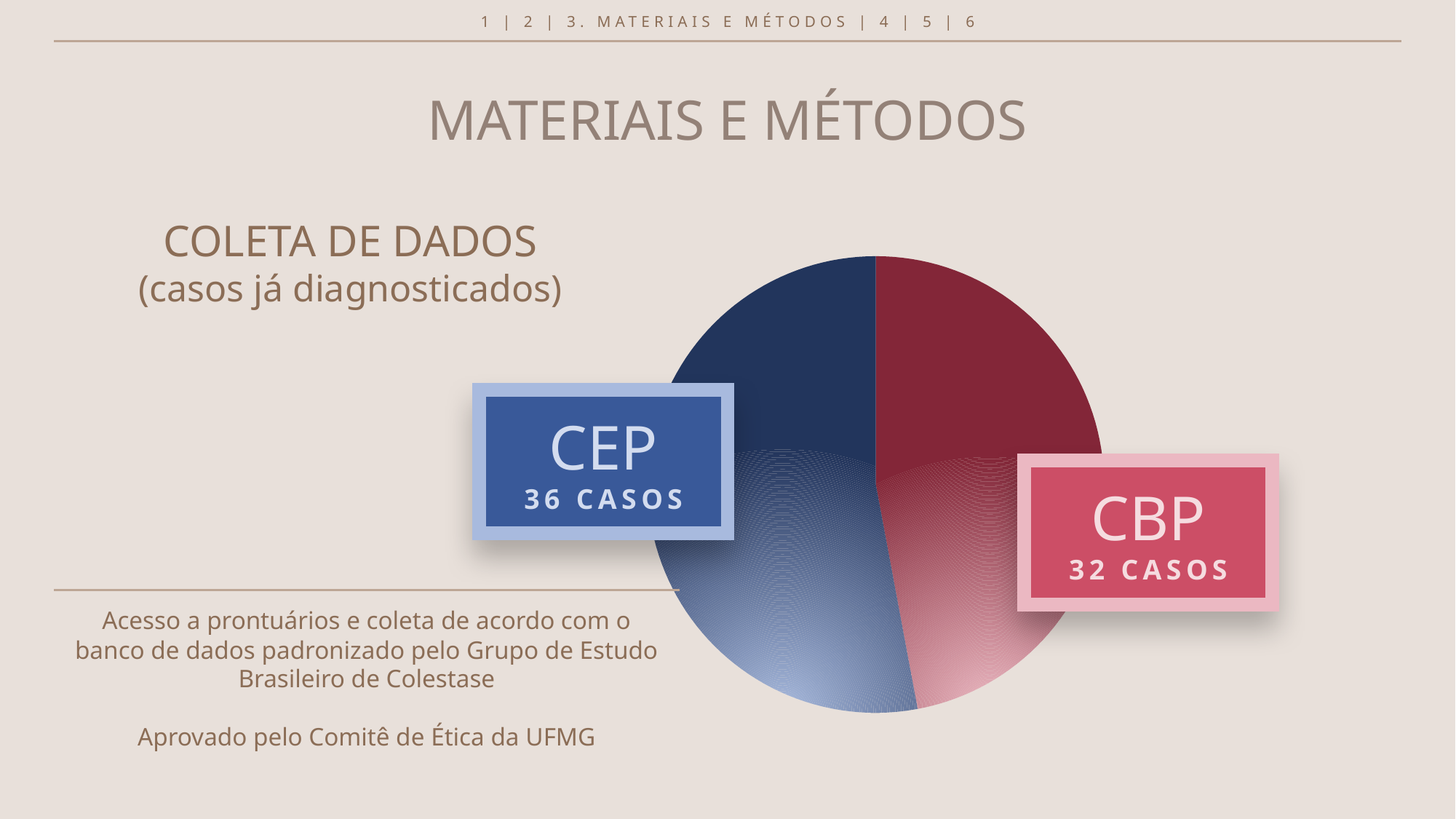
How many slices does the pie chart have? 2 Which category in the pie chart has the smaller number of cases? CBP Which has more cases, CBP or CEP? CEP How many cases does the CEP slice of the pie chart represent? 36 casos What is the difference in the number of cases between CEP and CBP? 4 What is the total number of cases across both slices of the pie chart? 68 What colour is the CEP slice of the pie chart? Blue What colour is the CBP slice of the pie chart? Red Which category in the pie chart has the larger number of cases? CEP What kind of chart is shown on the slide? Pie chart How many cases does the CBP slice of the pie chart represent? 32 casos